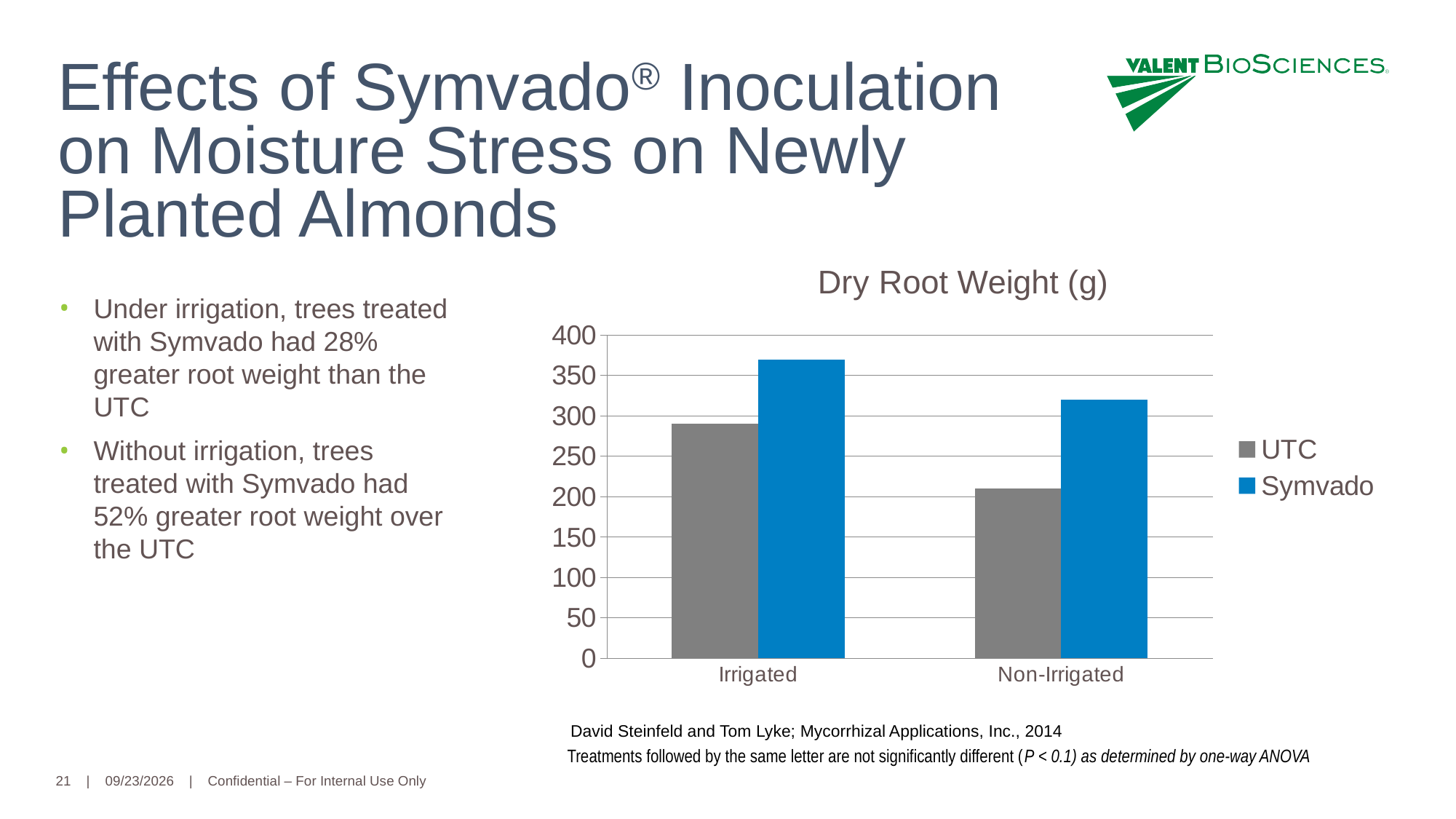
Which series is shown in blue in the chart? Symvado How many categories are shown on the x axis of the chart? 2 Is the Symvado value for Irrigated greater or less than 350? greater How many series does the chart legend list? 2 What kind of chart is shown on the slide? bar chart Is the Symvado value for Non-Irrigated greater or less than 300? greater Is the UTC value for Irrigated greater or less than 300? less What is the title of the chart? Dry Root Weight (g) Which bar in the chart is the shortest? UTC, Non-Irrigated Which is larger for Irrigated, the UTC value or the Symvado value? Symvado Which bar in the chart is the tallest? Symvado, Irrigated